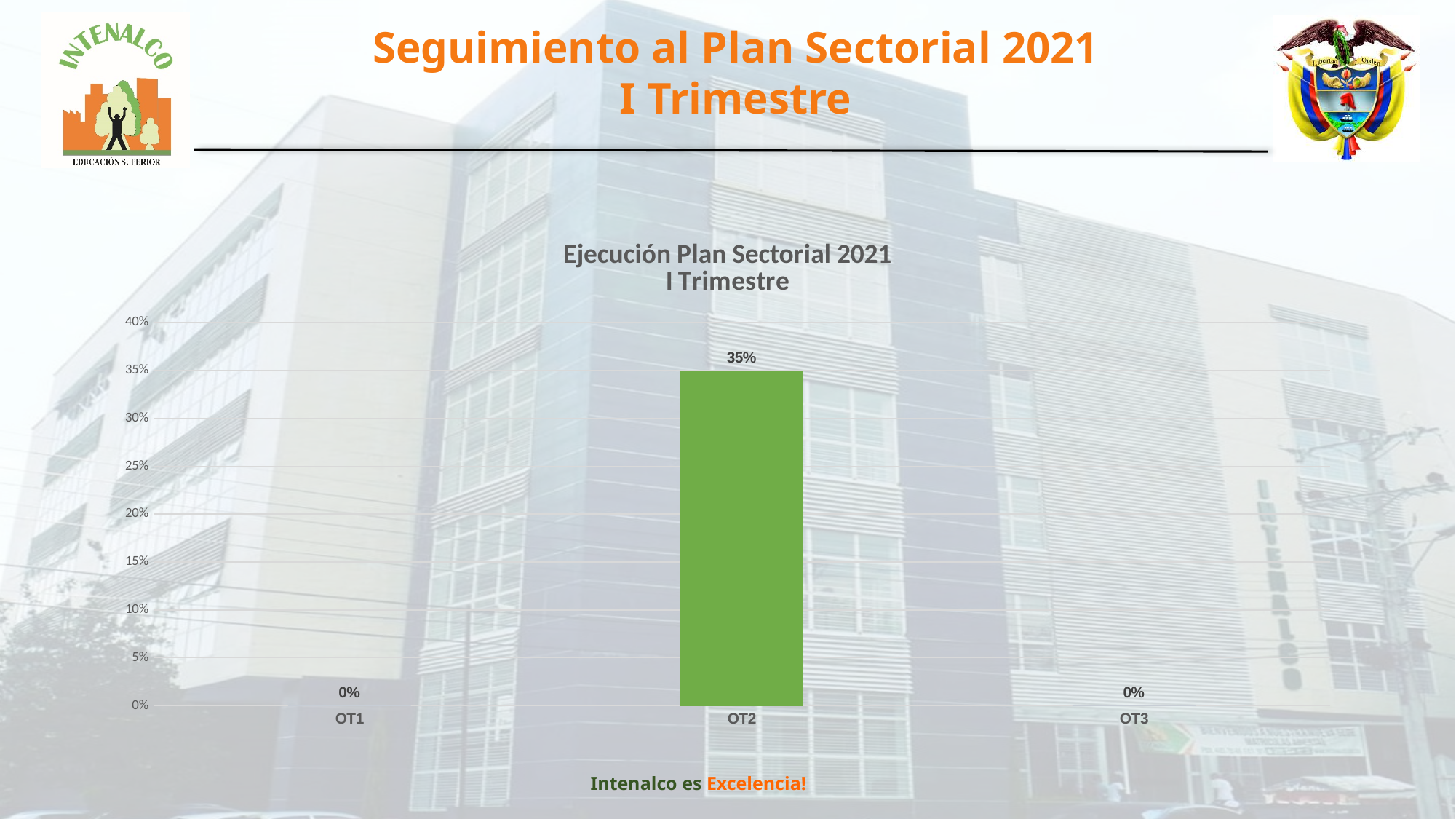
What colour is the bar for OT2? green What is the value for OT3? 0% What is the value for OT2? 35% What is the value for OT1? 0% Which is larger, the value for OT2 or the value for OT3? OT2 What kind of chart is shown on the slide? bar chart What is the title of the chart? Ejecución Plan Sectorial 2021 I Trimestre Is the value for OT2 greater or less than 30%? greater How many categories are shown on the x axis? 3 Which category has the highest value? OT2 What is the highest value shown on the y axis? 40% What is the difference between the values for OT2 and OT1? 35%